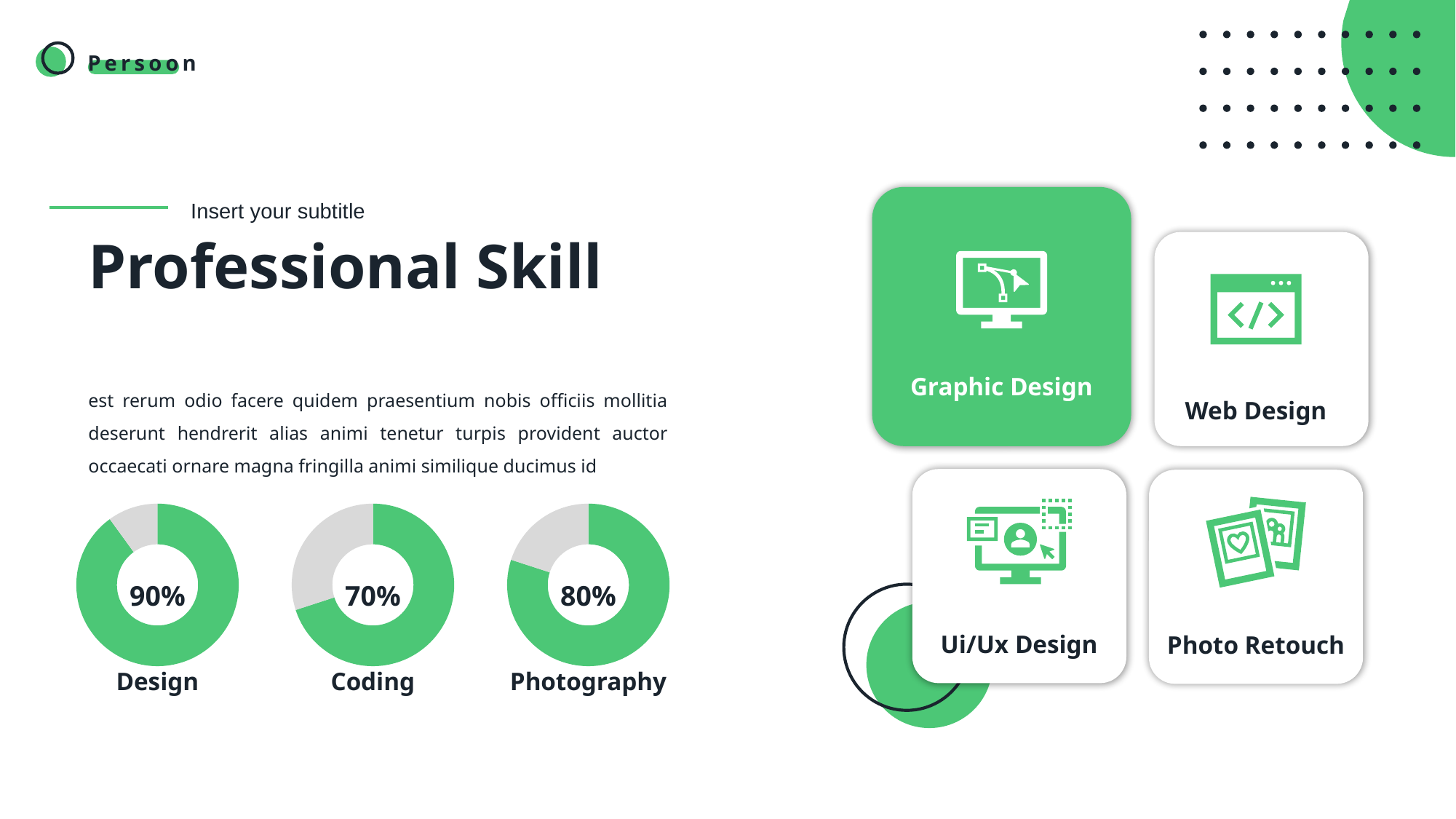
What percentage is shown in the Photography donut chart? 80% Which is larger, the Design percentage or the Photography percentage? Design What percentage is shown in the Design donut chart? 90% What is the label under the middle donut chart? Coding What colour is the filled portion of the donut charts? Green Which of the three skill donut charts shows the lowest percentage? Coding What is the difference between the Design and Coding percentages? 20% How many donut charts are shown on the slide? 3 Which of the three skill donut charts shows the highest percentage? Design What kind of chart is used to show the skill percentages? Donut chart What is the difference between the Photography and Coding percentages? 10% What percentage is shown in the Coding donut chart? 70%